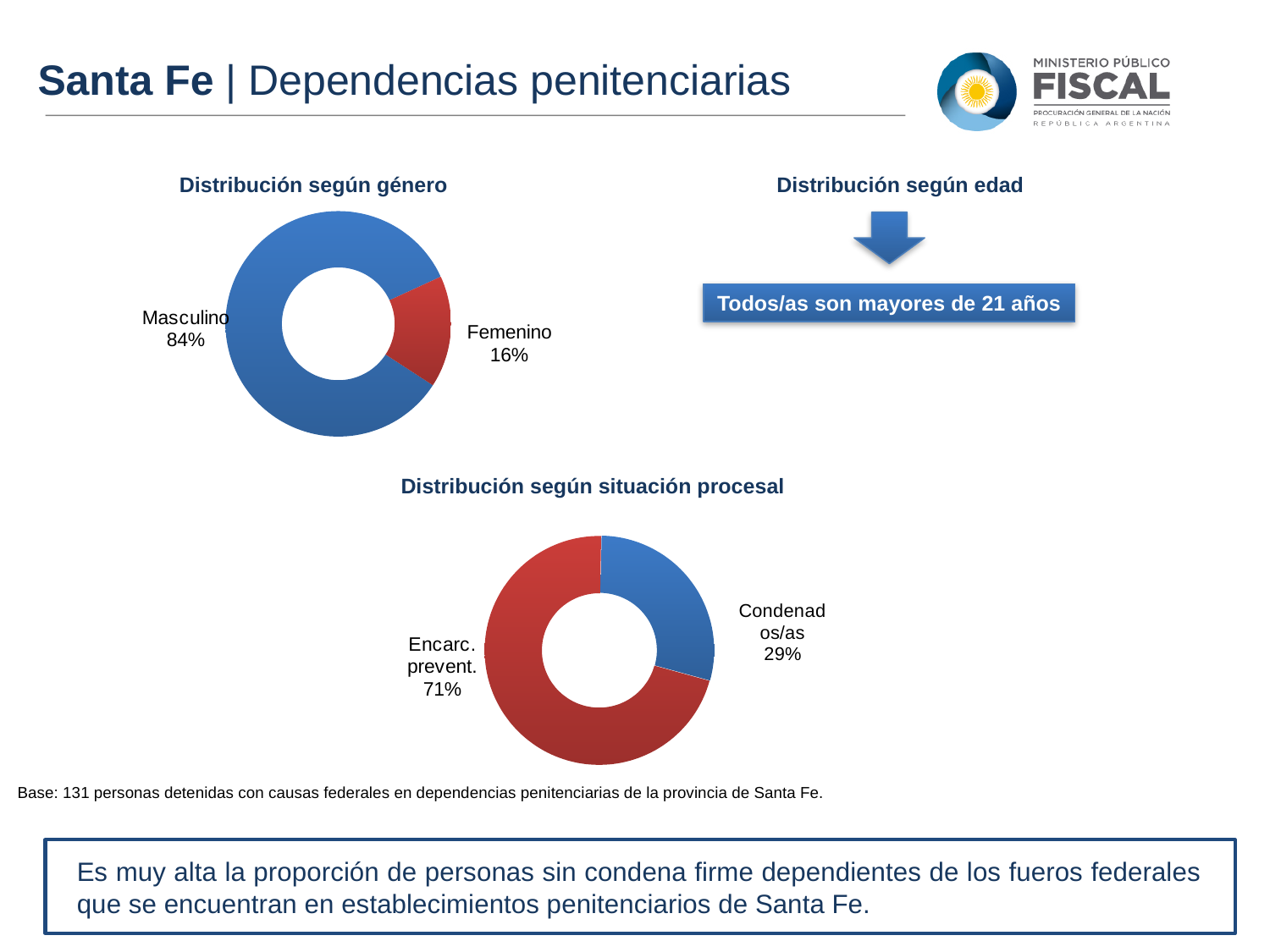
In the 'Distribución según género' chart, what share is Femenino? 16% In the 'Distribución según género' chart, which category has the largest share? Masculino In the 'Distribución según género' chart, what is the difference in percentage points between Masculino and Femenino? 68 In the 'Distribución según situación procesal' chart, what share is Encarc. prevent.? 71% In the 'Distribución según situación procesal' chart, what is the difference in percentage points between Encarc. prevent. and Condenados/as? 42 What kind of chart is 'Distribución según género'? Doughnut (pie) chart In the 'Distribución según situación procesal' chart, what share is Condenados/as? 29% How many categories does the 'Distribución según género' chart show? 2 In the 'Distribución según situación procesal' chart, what colour is the Condenados/as slice? Blue In the 'Distribución según situación procesal' chart, which category has the smallest share? Condenados/as In the 'Distribución según género' chart, what share is Masculino? 84% In the 'Distribución según situación procesal' chart, which is larger: Encarc. prevent. or Condenados/as? Encarc. prevent.